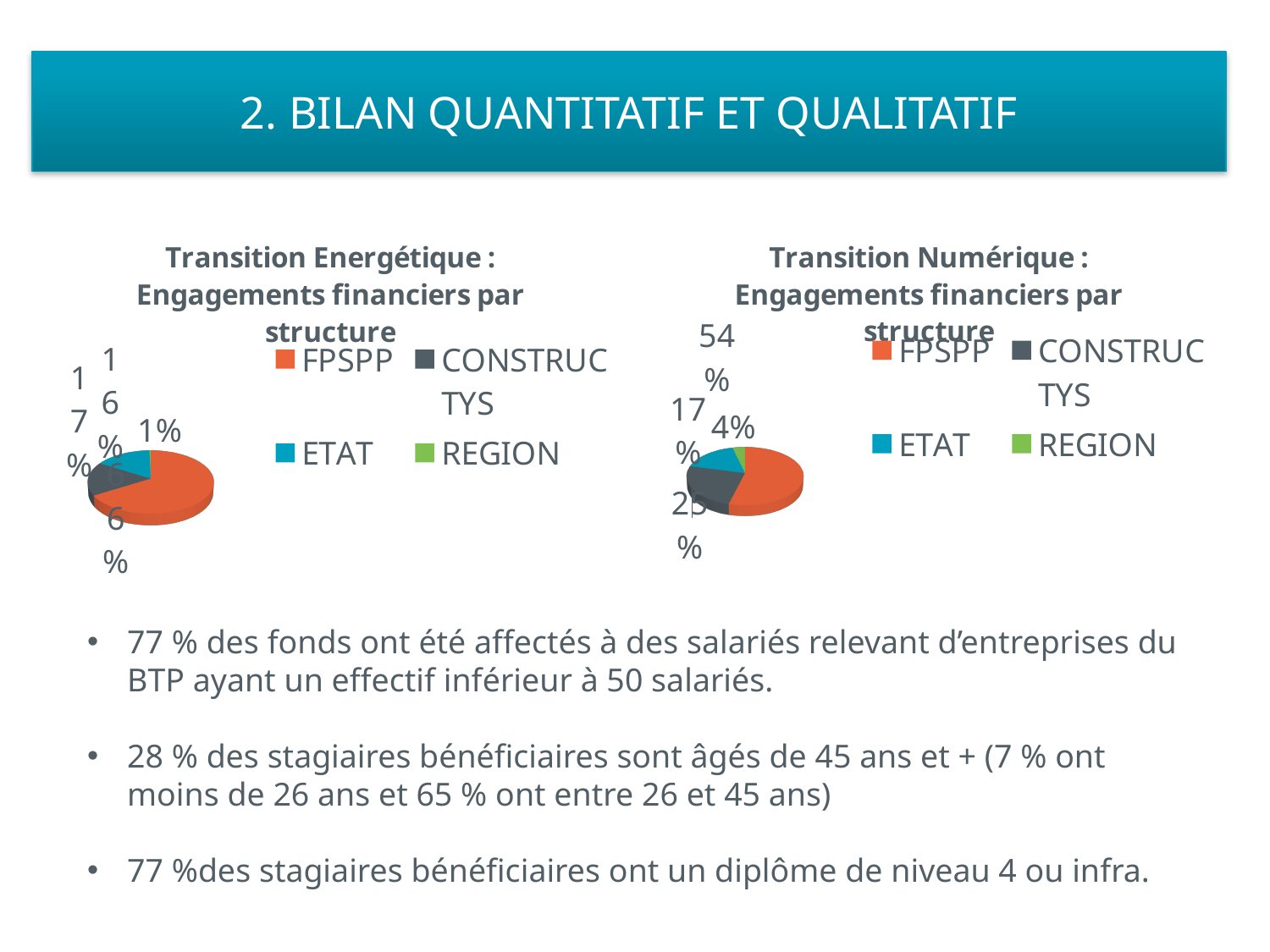
In the 'Transition Numérique : Engagements financiers par structure' chart, what share does REGION have? 4% In the 'Transition Numérique : Engagements financiers par structure' chart, which slice is larger, CONSTRUCTYS or ETAT? CONSTRUCTYS In the 'Transition Numérique : Engagements financiers par structure' chart, what share does ETAT have? 17% In the 'Transition Numérique : Engagements financiers par structure' chart, which structure has the largest slice? FPSPP In the 'Transition Numérique : Engagements financiers par structure' chart, what is the difference in percentage points between FPSPP and ETAT? 37% How many charts are shown on the slide? 2 In the 'Transition Energétique : Engagements financiers par structure' chart, which structure has the smallest slice? REGION In the 'Transition Energétique : Engagements financiers par structure' chart, what share does REGION have? 1% What kind of chart is the 'Transition Numérique : Engagements financiers par structure' chart? pie chart How many entries does the legend of the 'Transition Energétique : Engagements financiers par structure' chart list? 4 In the 'Transition Numérique : Engagements financiers par structure' chart, what share does FPSPP have? 54% What colour represents FPSPP in the legends of the pie charts? orange